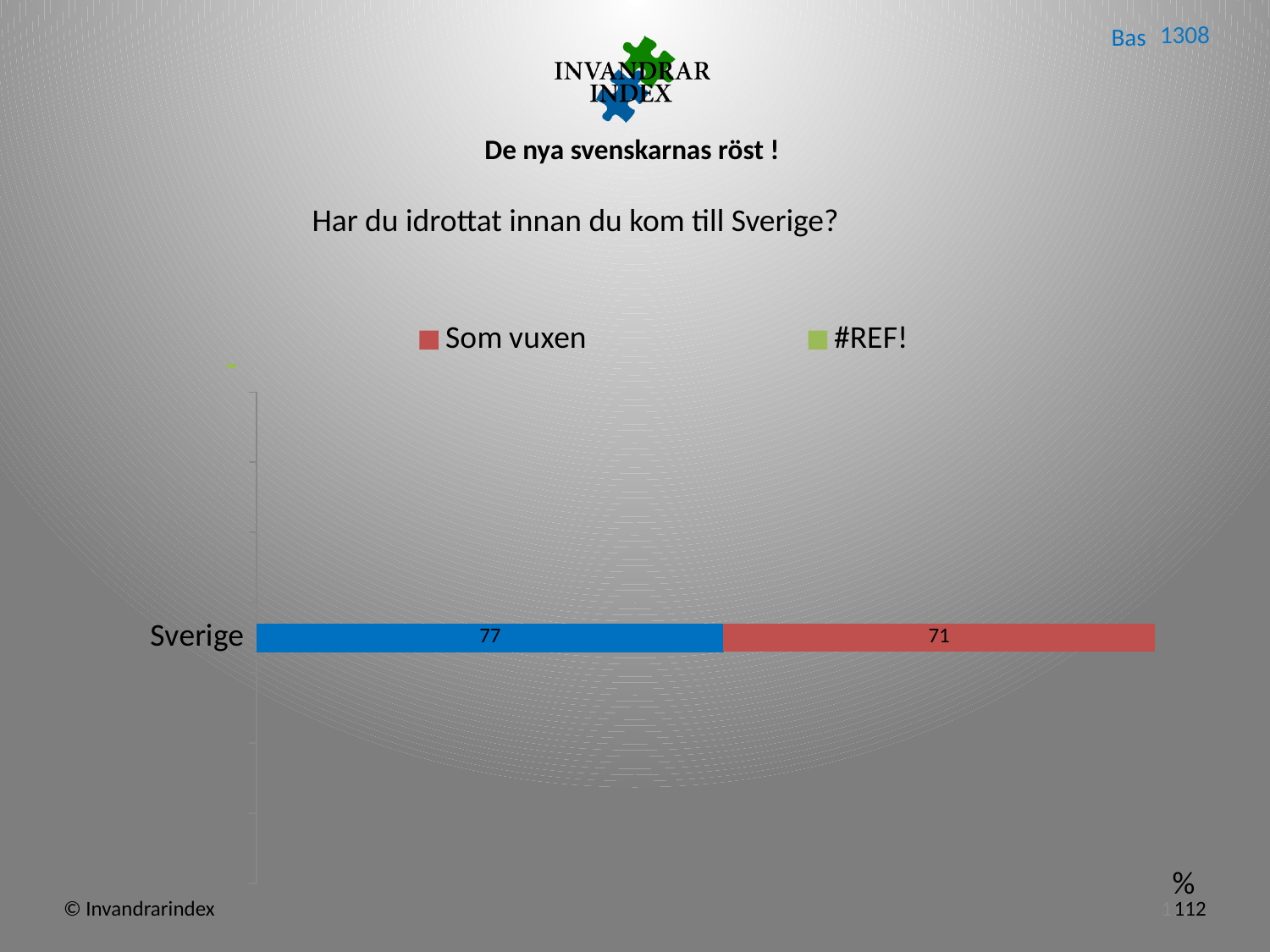
What question is the chart about, according to the text above it? Har du idrottat innan du kom till Sverige? Which segment of the Sverige bar has the smaller value? Som vuxen Which segment of the Sverige bar is larger, the blue segment or the red "Som vuxen" segment? the blue segment What kind of chart is shown on the slide? stacked bar chart What value is shown for the "Som vuxen" segment of the Sverige bar? 71 What is the difference between the blue segment (77) and the "Som vuxen" segment (71) of the Sverige bar? 6 How many categories are plotted on the chart? 1 What colour is the "Som vuxen" series in the legend? red What is the total of the two segments in the Sverige bar? 148 What value is printed on the blue segment of the Sverige bar? 77 What is the name of the only category on the chart's vertical axis? Sverige